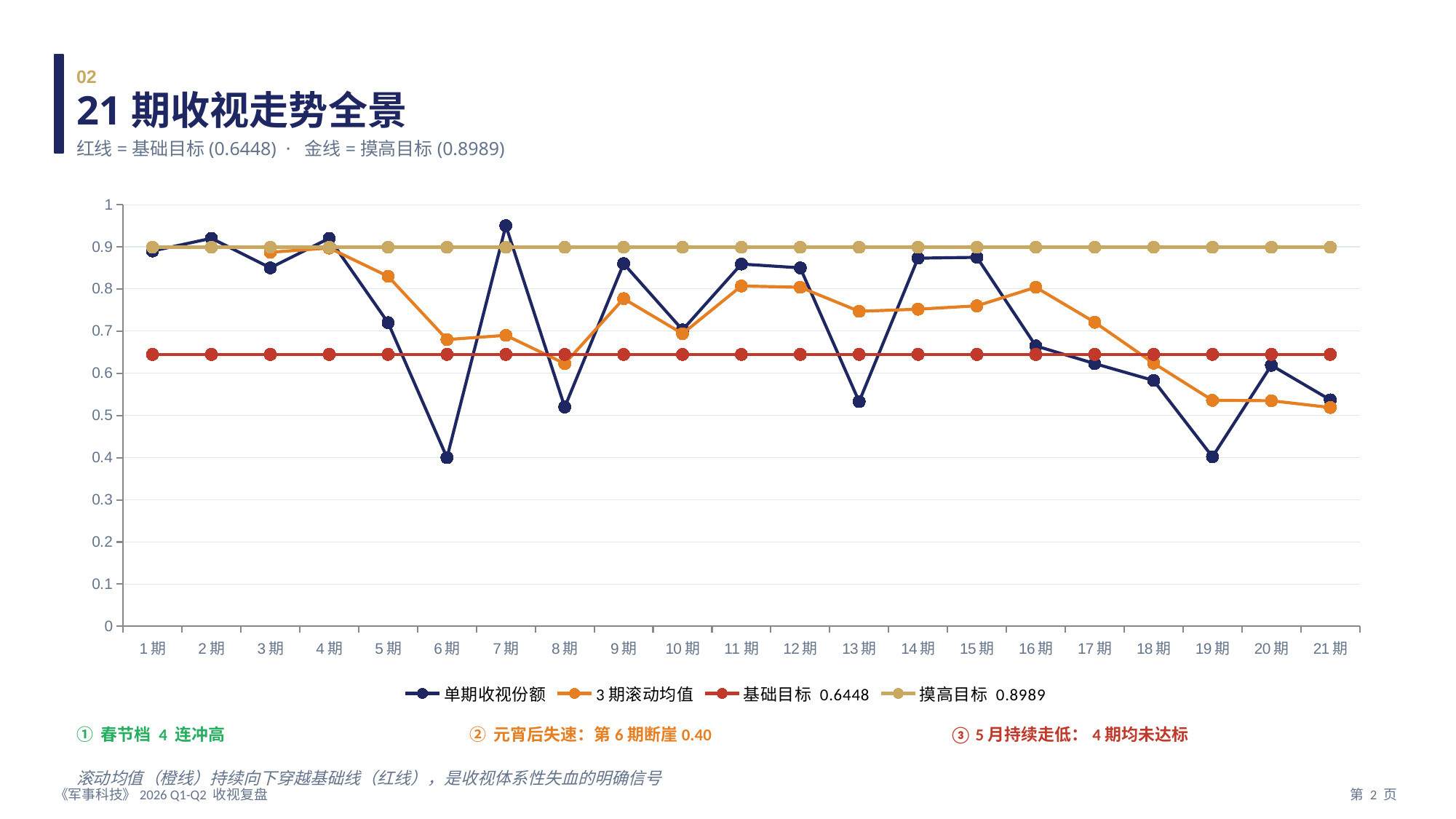
What is the value of the 摸高目标 line? 0.8989 Which is larger, the 单期收视份额 for 7 期 or for 8 期? 7 期 Does the 3 期滚动均值 line rise or fall from 16 期 to 21 期? fall Is the 单期收视份额 value for 13 期 greater or less than 0.6? less Is the 3 期滚动均值 value for 21 期 greater or less than 0.6? less What is the 单期收视份额 value for 6 期? 0.40 What is the difference between the 摸高目标 and the 基础目标 values? 0.2541 Which episode has the highest 单期收视份额? 7 期 How many series does the legend list? 4 What is the value of the 基础目标 line? 0.6448 How many episodes (期) are plotted along the x axis? 21 What kind of chart is shown on the slide? Line chart